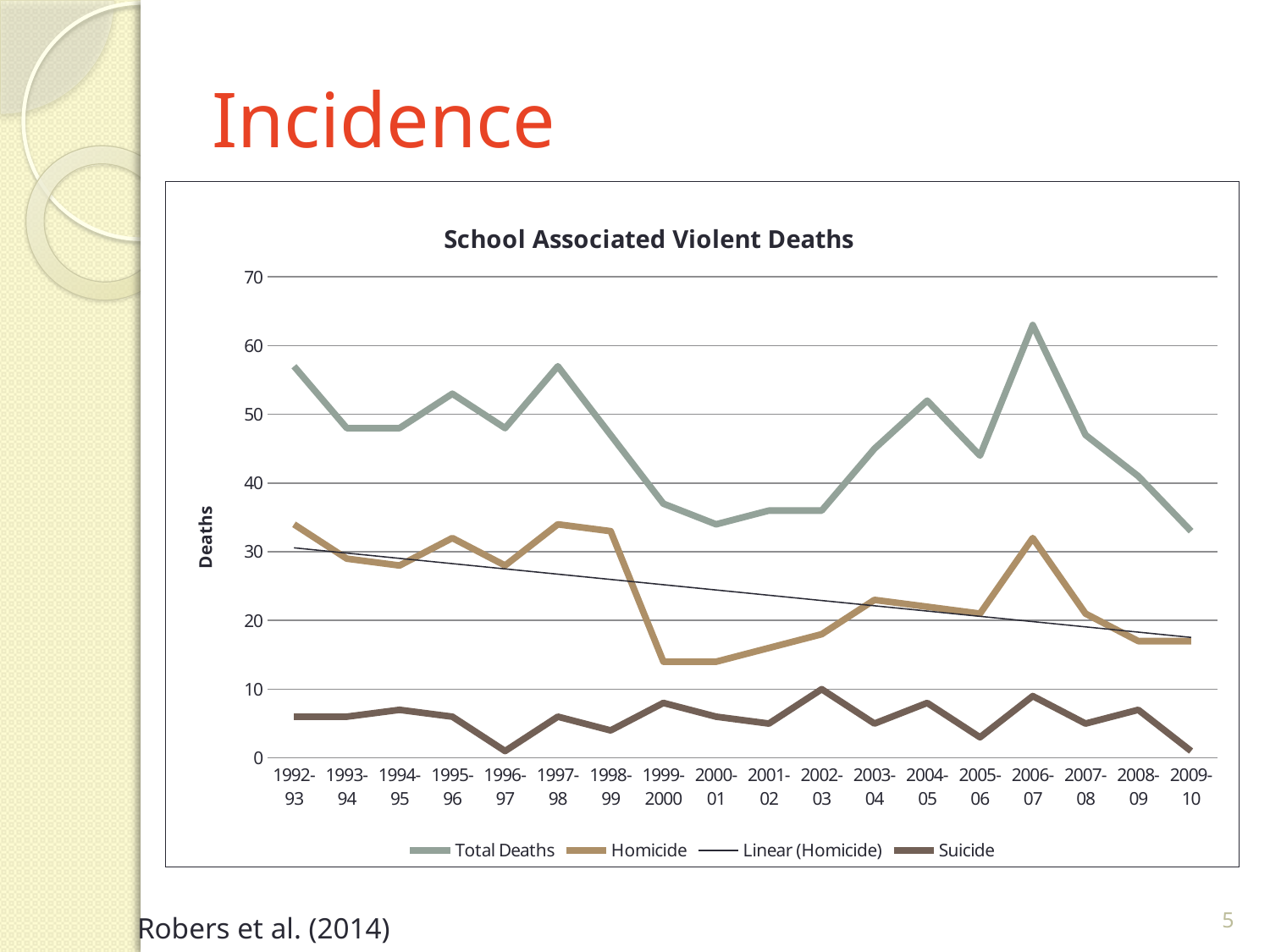
Does the Linear (Homicide) trend line rise or fall across the x axis? Fall What kind of chart is shown on the slide? Line chart Which is larger: Total Deaths in 2006-07 or Total Deaths in 1997-98? 2006-07 Is the value for Suicide in 1996-97 greater or less than 10? less What is the label on the vertical axis? Deaths In which school year is the Total Deaths series highest? 2006-07 How many school years are shown along the x axis? 18 How many series does the legend list? 4 Is the value for Total Deaths in 2006-07 greater or less than 60? greater Is the value for Homicide in 1999-2000 greater or less than 20? less What is the title of the chart? School Associated Violent Deaths